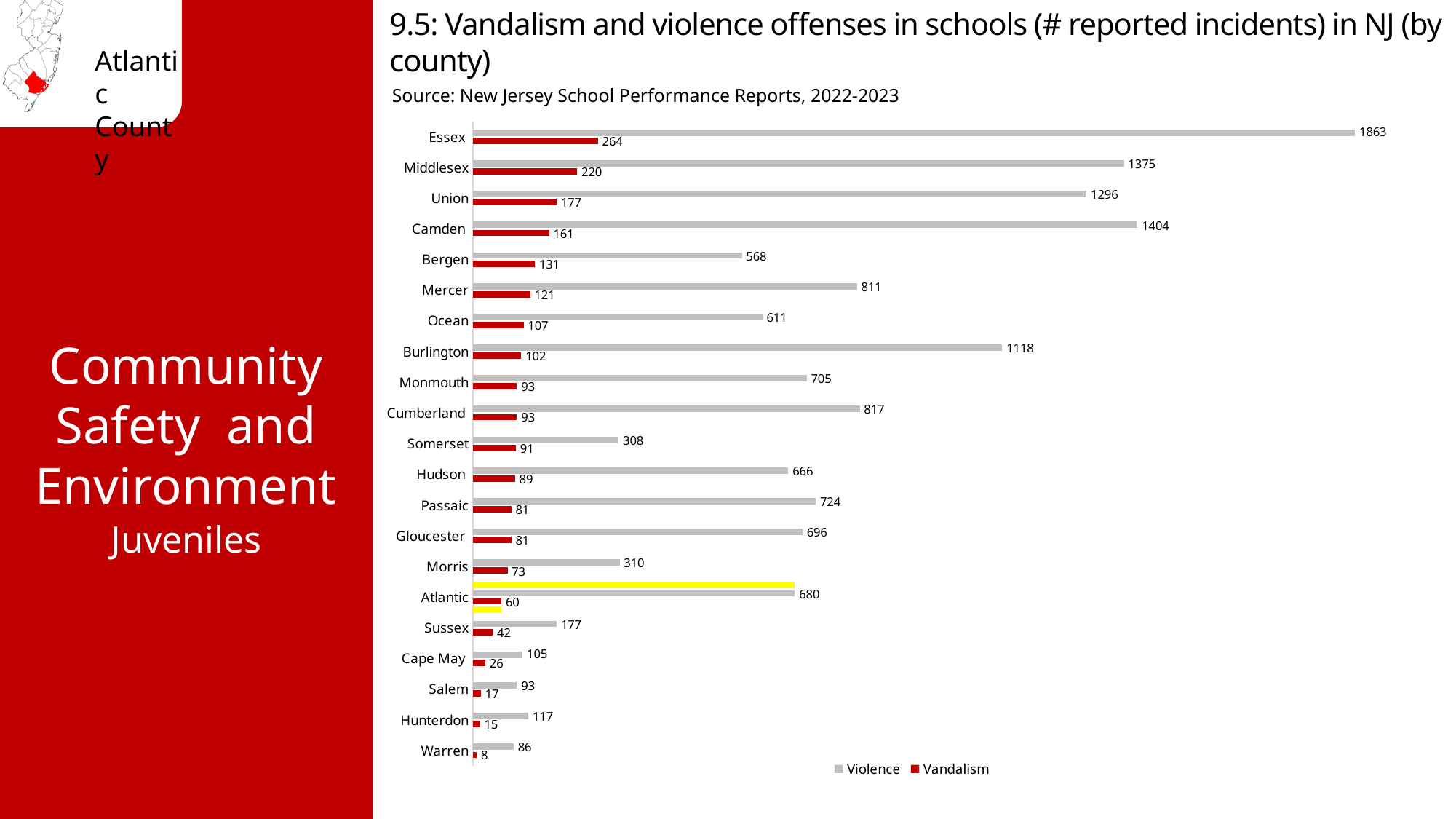
Which county has the highest number of reported violence incidents? Essex What type of chart is shown on the slide? Bar chart What is the difference between the violence and vandalism values for Atlantic County? 620 What is the violence value for Camden County? 1404 How many reported vandalism incidents are shown for Essex County? 264 What is the difference between the violence values for Essex and Middlesex? 488 How many reported violence incidents are shown for Atlantic County? 680 How many counties are shown on the chart? 21 Which county has more reported violence incidents, Camden or Middlesex? Camden Which county has more reported vandalism incidents, Bergen or Mercer? Bergen How many series does the legend list? 2 Which county has the lowest number of reported vandalism incidents? Warren